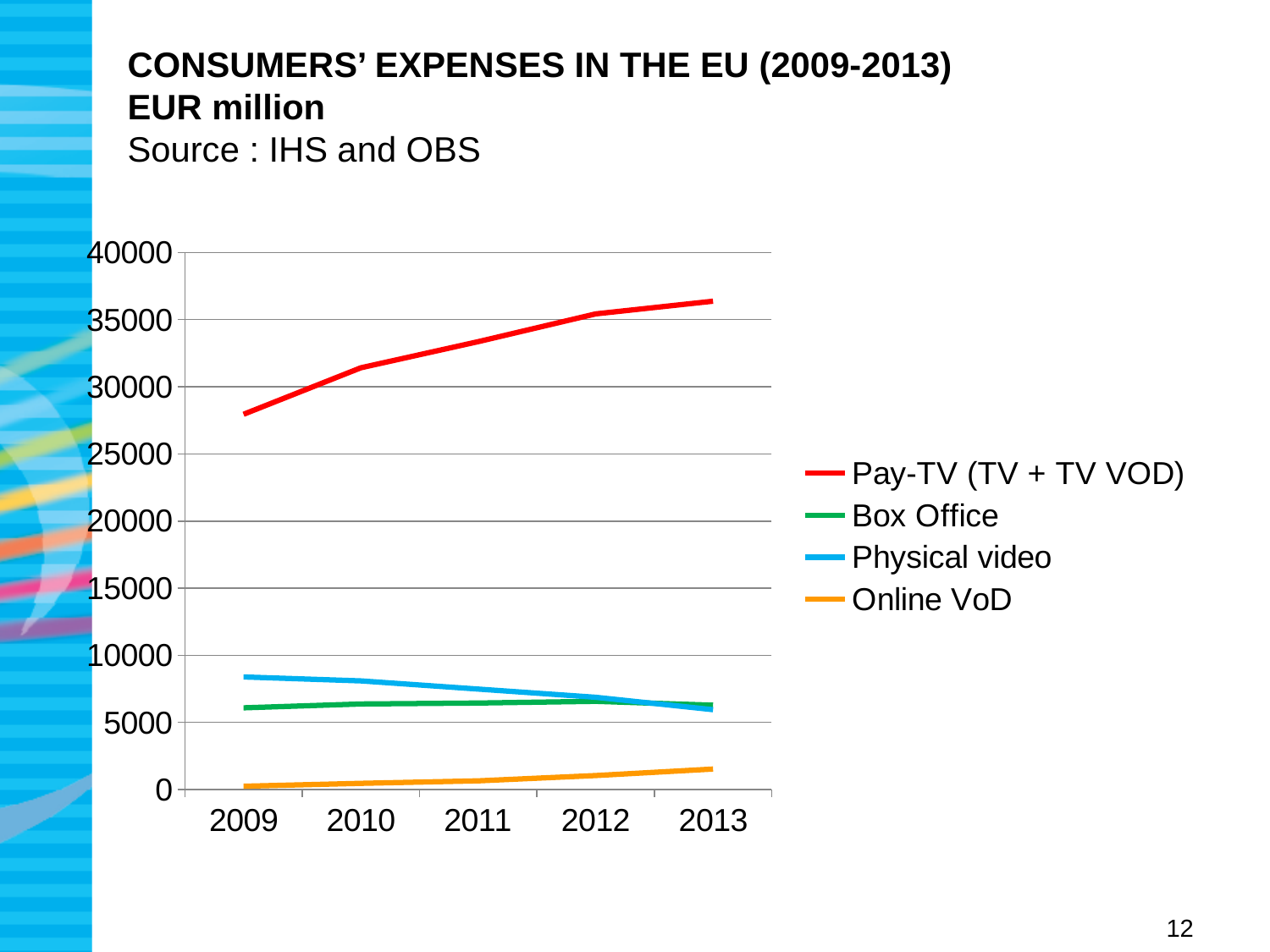
Which series has the lowest values across all years? Online VoD How many series does the legend list? 4 Is the value for Pay-TV (TV + TV VOD) in 2013 greater or less than 35000? greater In 2009, which is larger: Physical video or Box Office? Physical video How many years are shown on the x axis? 5 Is the value for Pay-TV (TV + TV VOD) in 2009 greater or less than 30000? less Which series has the highest values across all years? Pay-TV (TV + TV VOD) What kind of chart is shown on the slide? line chart Does the Physical video series rise or fall from 2009 to 2013? fall Is the value for Physical video in 2009 greater or less than 10000? less What unit is stated in the chart title? EUR million Does the Pay-TV (TV + TV VOD) series rise or fall from 2009 to 2013? rise